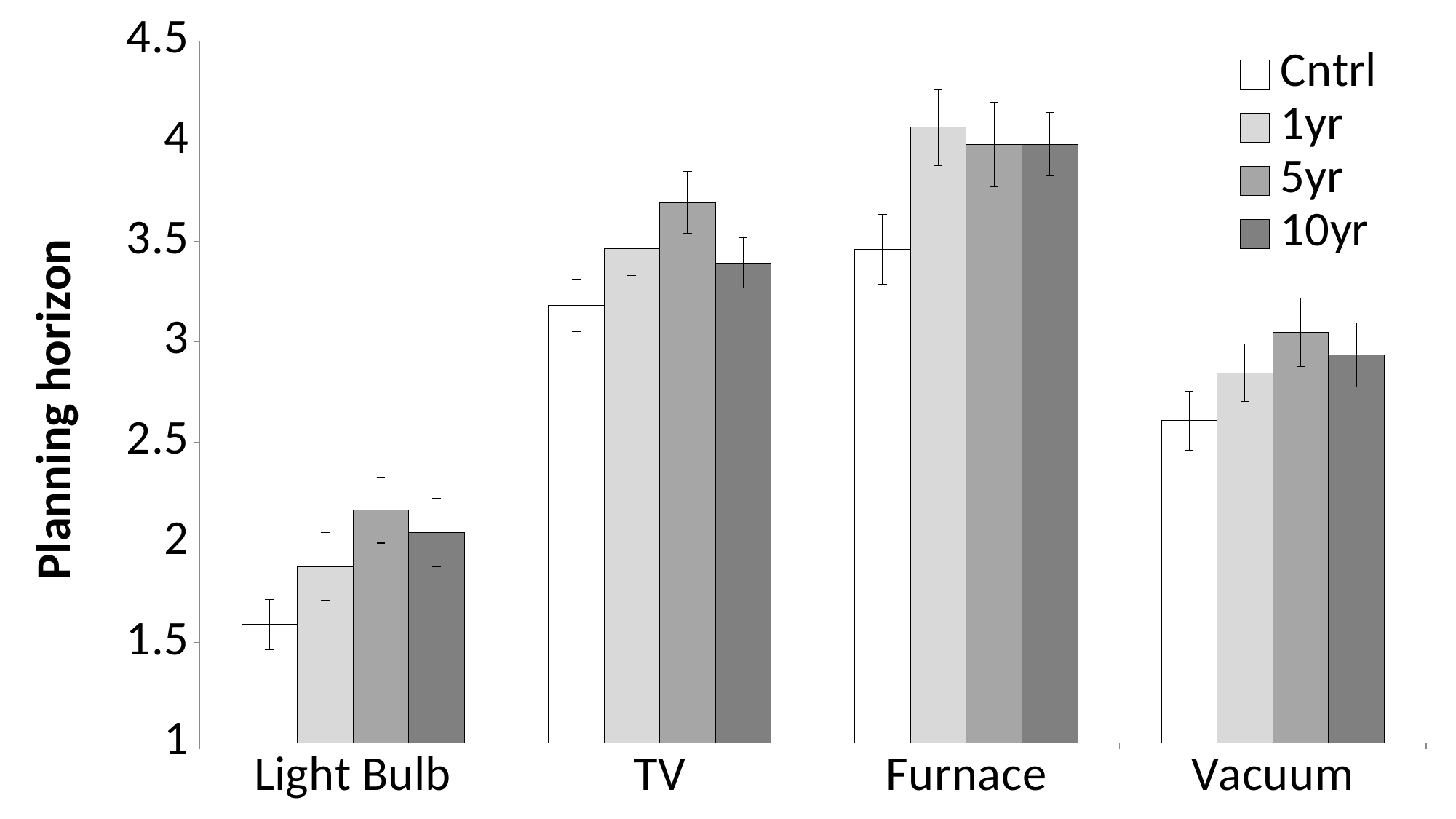
Which product category has the highest Cntrl value? Furnace What kind of chart is shown on the slide? bar chart How many product categories are shown on the x axis? 4 Is the 1yr value for Furnace greater or less than 4? greater Is the Cntrl value for Light Bulb greater or less than 2? less Is the Cntrl value for Vacuum greater or less than 2.5? greater How many series does the legend list? 4 What is the title of the y axis? Planning horizon For TV, which series has the highest planning horizon? 5yr Which product category has the lowest Cntrl value? Light Bulb What are the four legend entries? Cntrl, 1yr, 5yr, 10yr